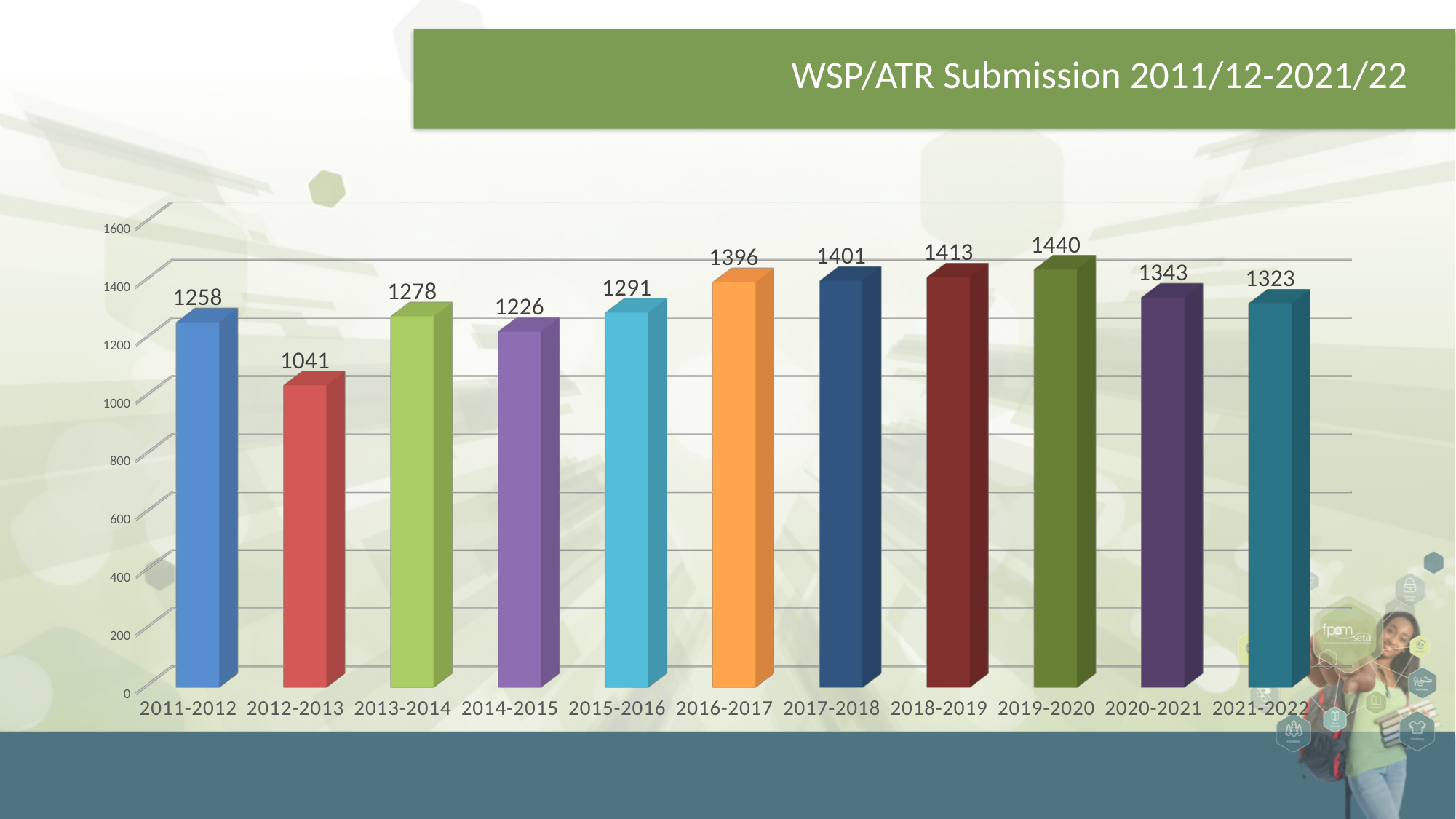
What is the value for 2016-2017? 1396 What is the difference between the values for 2020-2021 and 2021-2022? 20 What kind of chart is shown on the slide? bar chart What is the difference between the values for 2019-2020 and 2012-2013? 399 What is the value for 2011-2012? 1258 What is the value for 2021-2022? 1323 Which year has the highest value? 2019-2020 What is the title of the chart? WSP/ATR Submission 2011/12-2021/22 How many years are shown on the x axis? 11 Which year has the lowest value? 2012-2013 Is the value for 2012-2013 greater or less than 1200? less Which is larger, the value for 2013-2014 or the value for 2014-2015? 2013-2014